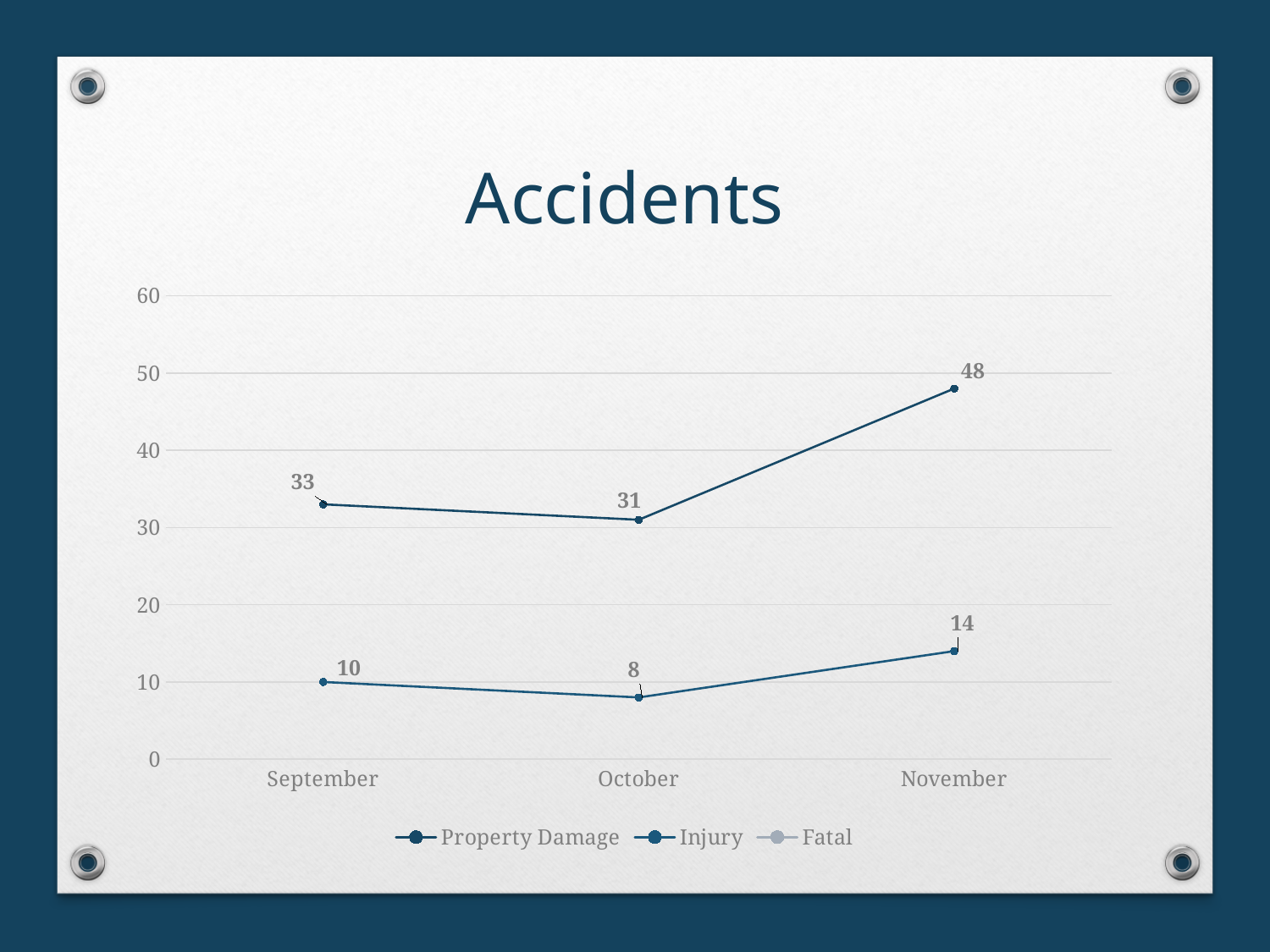
In which month is Injury lowest? October What is the Injury value for October? 8 What is the Property Damage value for September? 33 What is the title of the chart? Accidents How many series does the legend list? 3 What is the Property Damage value for November? 48 How many months are shown on the x axis? 3 What type of chart is shown on the slide? Line chart What is the difference between Property Damage and Injury in November? 34 In which month is Property Damage highest? November Does the Injury series rise or fall from October to November? Rise Which is larger, Property Damage in September or Property Damage in October? September